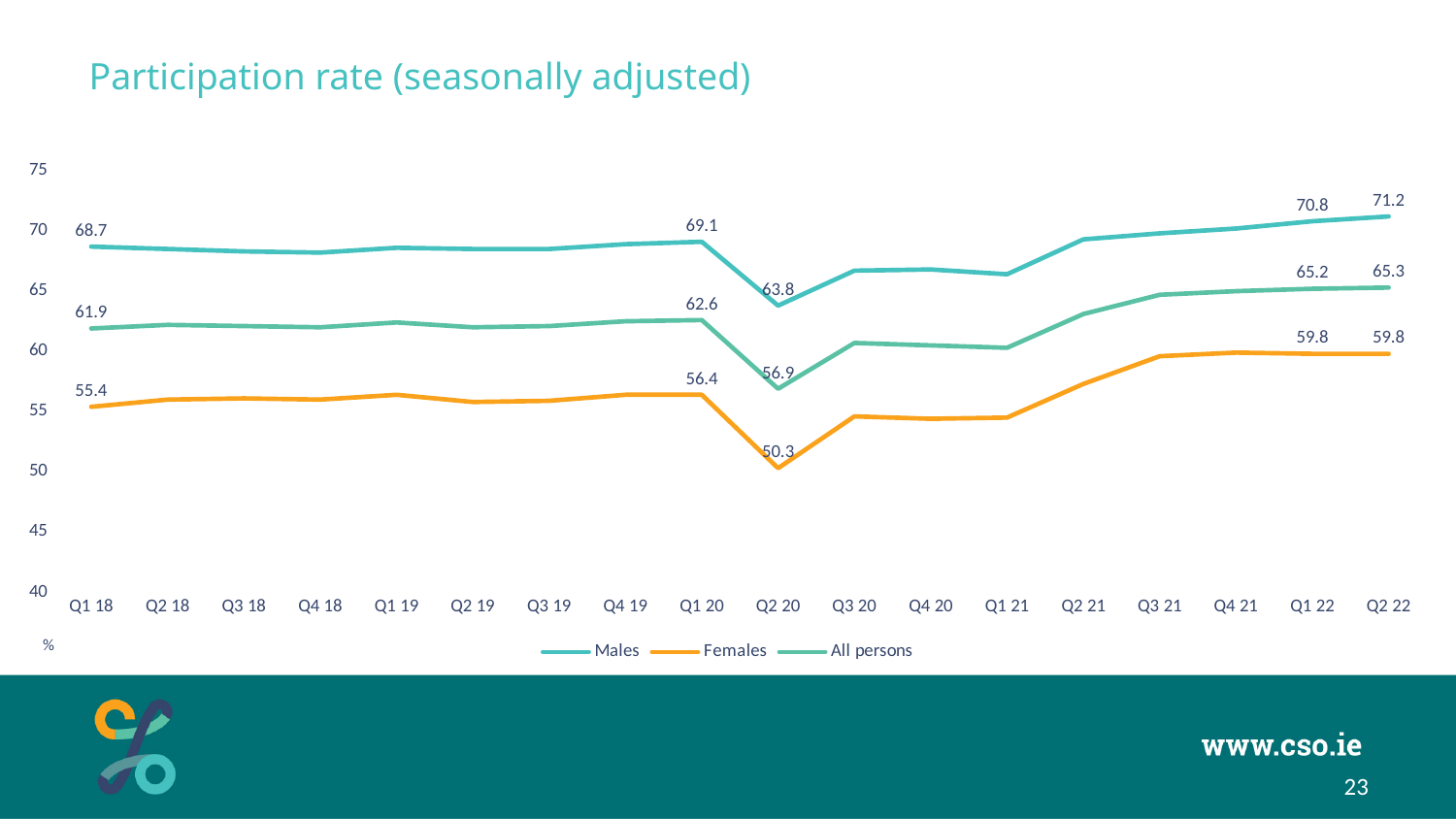
What is the participation rate for Males in Q2 22? 71.2 How many series does the legend list? 3 How many quarters are shown on the x axis? 18 Is the Males participation rate in Q2 20 greater or less than the All persons rate in Q2 20? greater What type of chart is shown on the slide? Line chart Which series has the lowest participation rate in Q2 20? Females By how much did the Females participation rate change from Q1 18 to Q2 22? 4.4 What is the participation rate for Females in Q2 20? 50.3 What is the participation rate for All persons in Q1 18? 61.9 What is the difference between the Males and Females participation rates in Q1 20? 12.7 What is the title of the chart? Participation rate (seasonally adjusted)